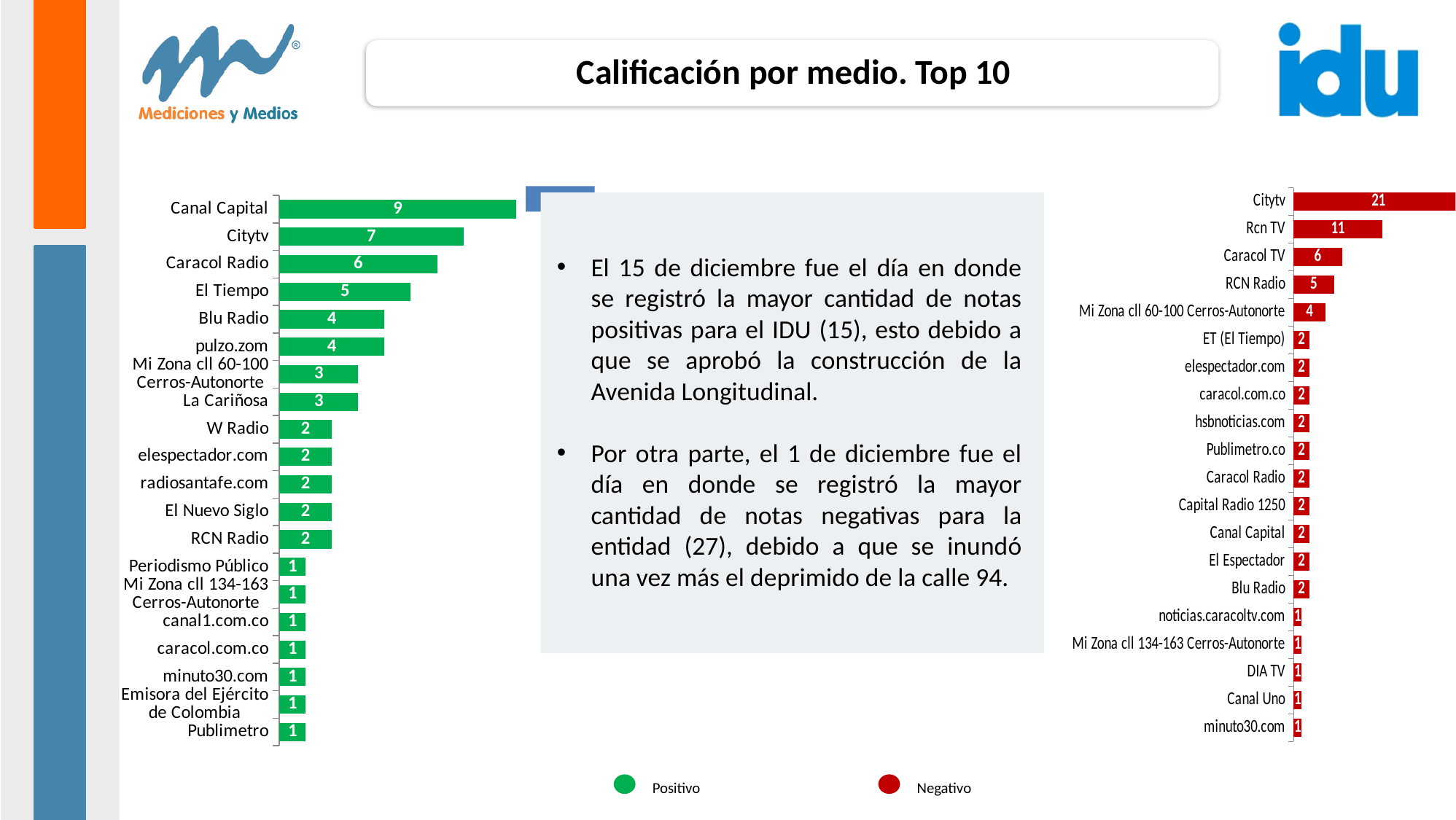
In the green (Positivo) chart on the left, what is the value for Canal Capital? 9 In the green (Positivo) chart on the left, which medium has the highest value? Canal Capital In the red (Negativo) chart on the right, what is the value for Rcn TV? 11 In the red (Negativo) chart on the right, what is the difference between Citytv and Rcn TV? 10 In the red (Negativo) chart on the right, which medium has the highest value? Citytv How many media are listed in the red (Negativo) chart on the right? 20 In the green (Positivo) chart on the left, what is the difference between Canal Capital and El Tiempo? 4 In the green (Positivo) chart on the left, which is larger, Citytv or Blu Radio? Citytv In the green (Positivo) chart on the left, what is the value for Caracol Radio? 6 What two series does the legend at the bottom of the slide list? Positivo and Negativo In the red (Negativo) chart on the right, what is the value for Citytv? 21 What type of chart is the green (Positivo) chart on the left? Bar chart